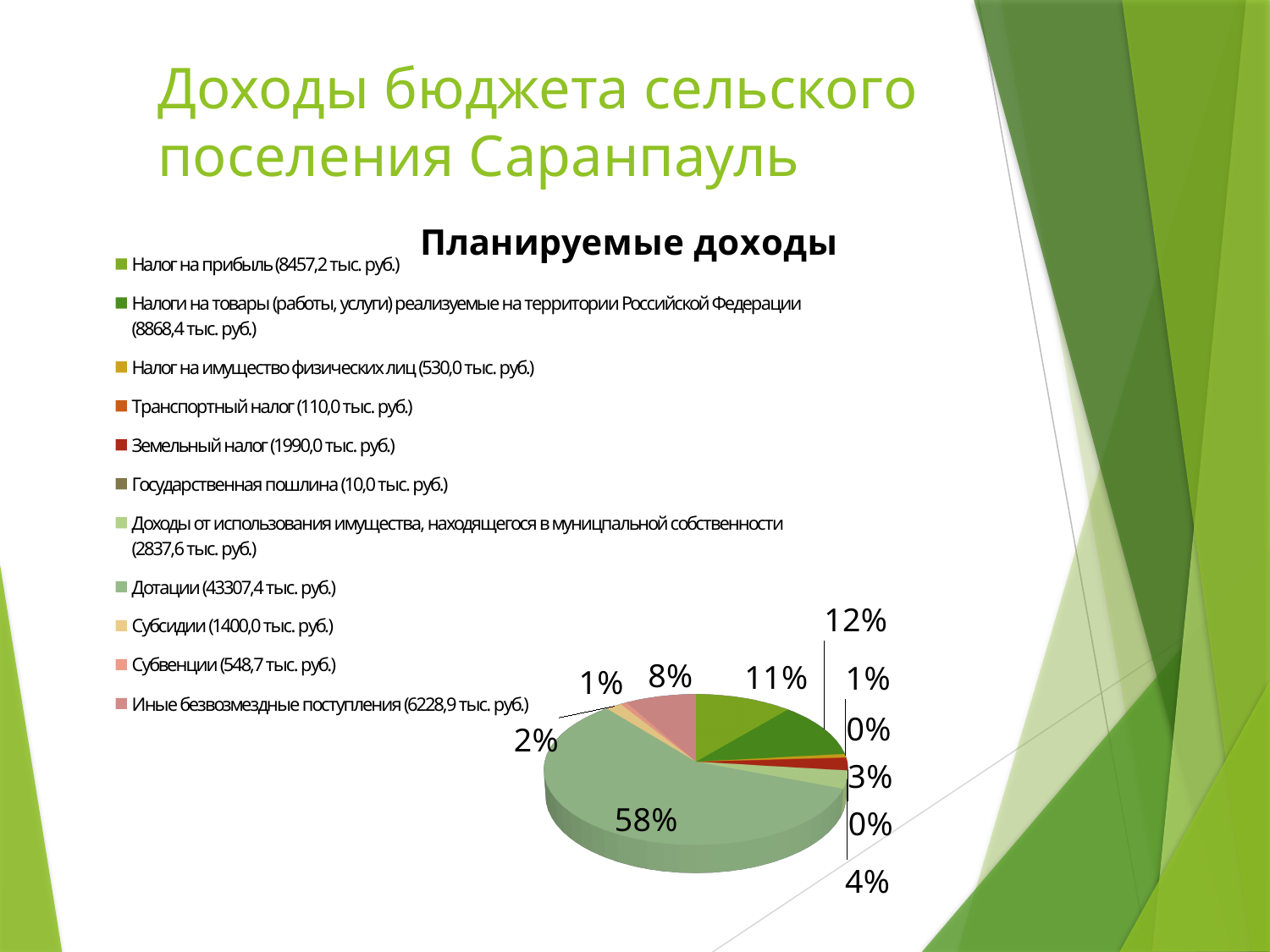
What is the planned amount for Субсидии as shown in the legend? 1400,0 тыс. руб. Which is larger: Земельный налог or Транспортный налог? Земельный налог What kind of chart is shown on the slide? Pie chart What share of the pie does Налог на прибыль take? 11% Which category has the largest slice of the pie? Дотации What is the title of the chart? Планируемые доходы What is the planned amount for Земельный налог as shown in the legend? 1990,0 тыс. руб. What share of the pie does Иные безвозмездные поступления take? 8% Which category has the smallest planned amount according to the legend? Государственная пошлина (10,0 тыс. руб.) What is the difference between the amounts for Налоги на товары (работы, услуги) реализуемые на территории Российской Федерации and Налог на прибыль? 411,2 тыс. руб. How many categories does the legend of the pie chart list? 11 What share of the pie does Дотации take? 58%